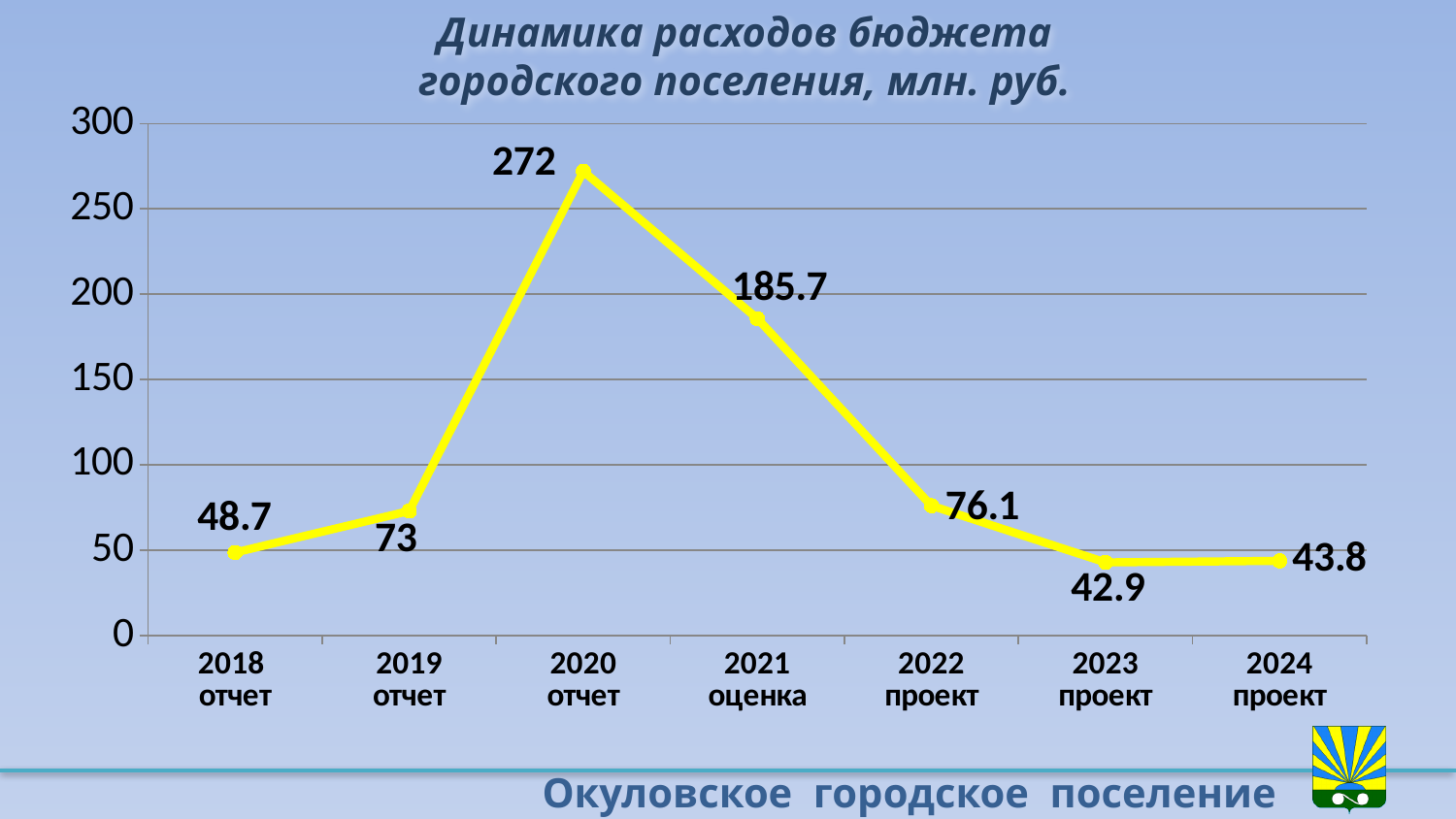
What is the value shown for 2024 проект? 43.8 Which year has the lowest budget expenditure? 2023 проект What is the title of the chart? Динамика расходов бюджета городского поселения, млн. руб. What kind of chart is shown on the slide? line chart What is the budget expenditure value for 2020 отчет? 272 Which year has the highest budget expenditure? 2020 отчет Which is larger, the value for 2018 отчет or the value for 2019 отчет? 2019 отчет What is the value shown for 2021 оценка? 185.7 Do the values rise or fall from 2020 отчет to 2023 проект? fall How many years are plotted on the chart? 7 What is the difference between the values for 2020 отчет and 2021 оценка? 86.3 Is the value for 2022 проект greater or less than 100? less